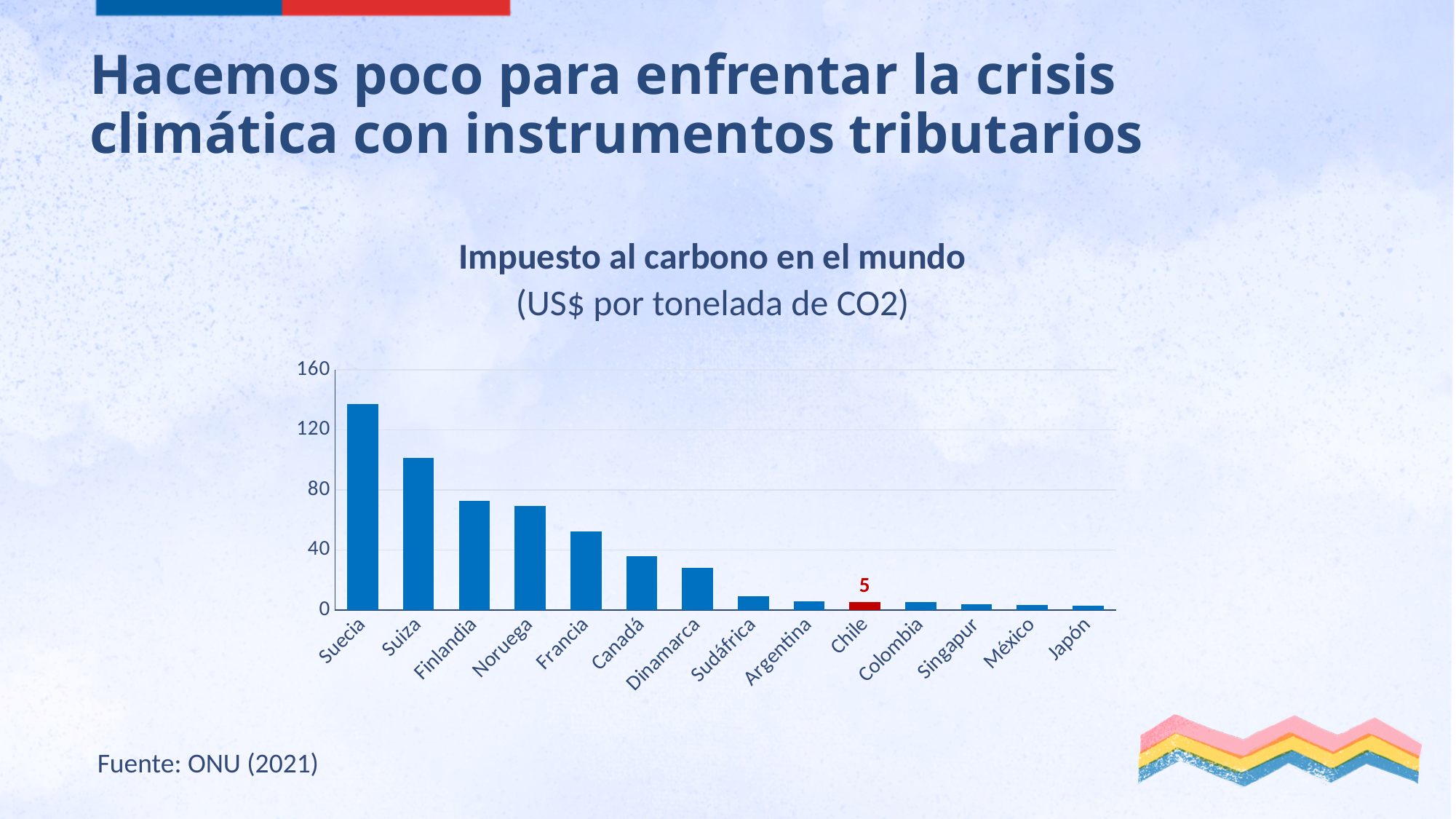
Which country has the highest carbon tax in the chart? Suecia Do the values rise or fall moving from left to right along the x axis? fall Which country's bar is highlighted in red? Chile Is the value for Finlandia greater or less than 80? less Is the value for Canadá greater or less than 40? less Is the value for Suiza greater or less than 80? greater How many countries are shown in the chart? 14 Which has a higher carbon tax, Suecia or Suiza? Suecia What kind of chart is shown on the slide? bar chart What is the carbon tax value shown for Chile? 5